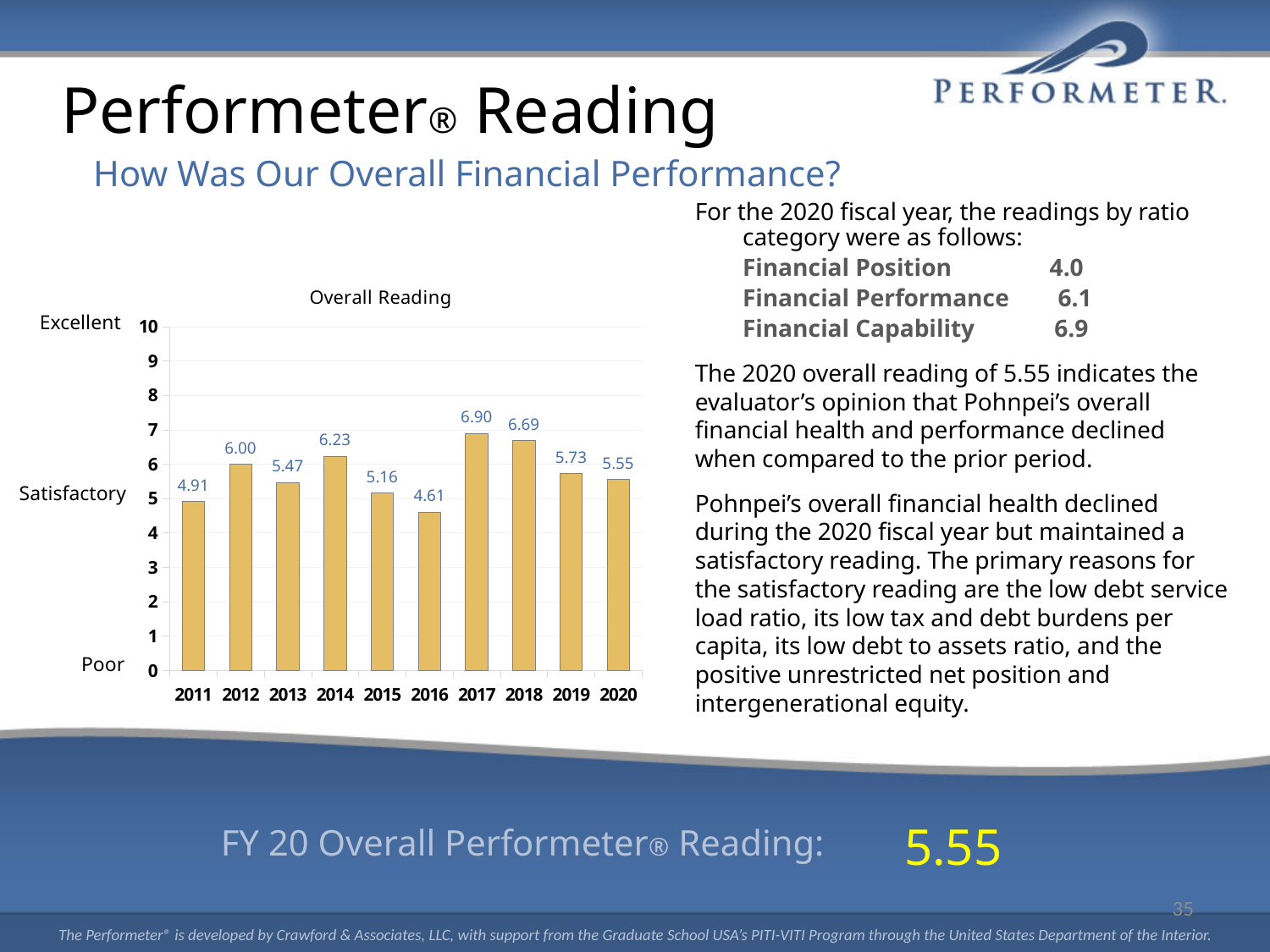
What is the title of the chart? Overall Reading Is the overall reading for 2011 greater or less than 5? less What is the difference between the overall readings for 2019 and 2020? 0.18 What is the overall reading for 2020? 5.55 Which year has the lowest overall reading? 2016 What kind of chart is shown on the slide? bar chart Did the overall reading rise or fall from 2017 to 2020? fall Which year has a higher overall reading, 2012 or 2013? 2012 What is the overall reading for 2016? 4.61 Which year has the highest overall reading? 2017 How many years are shown on the chart? 10 What is the overall reading for 2014? 6.23